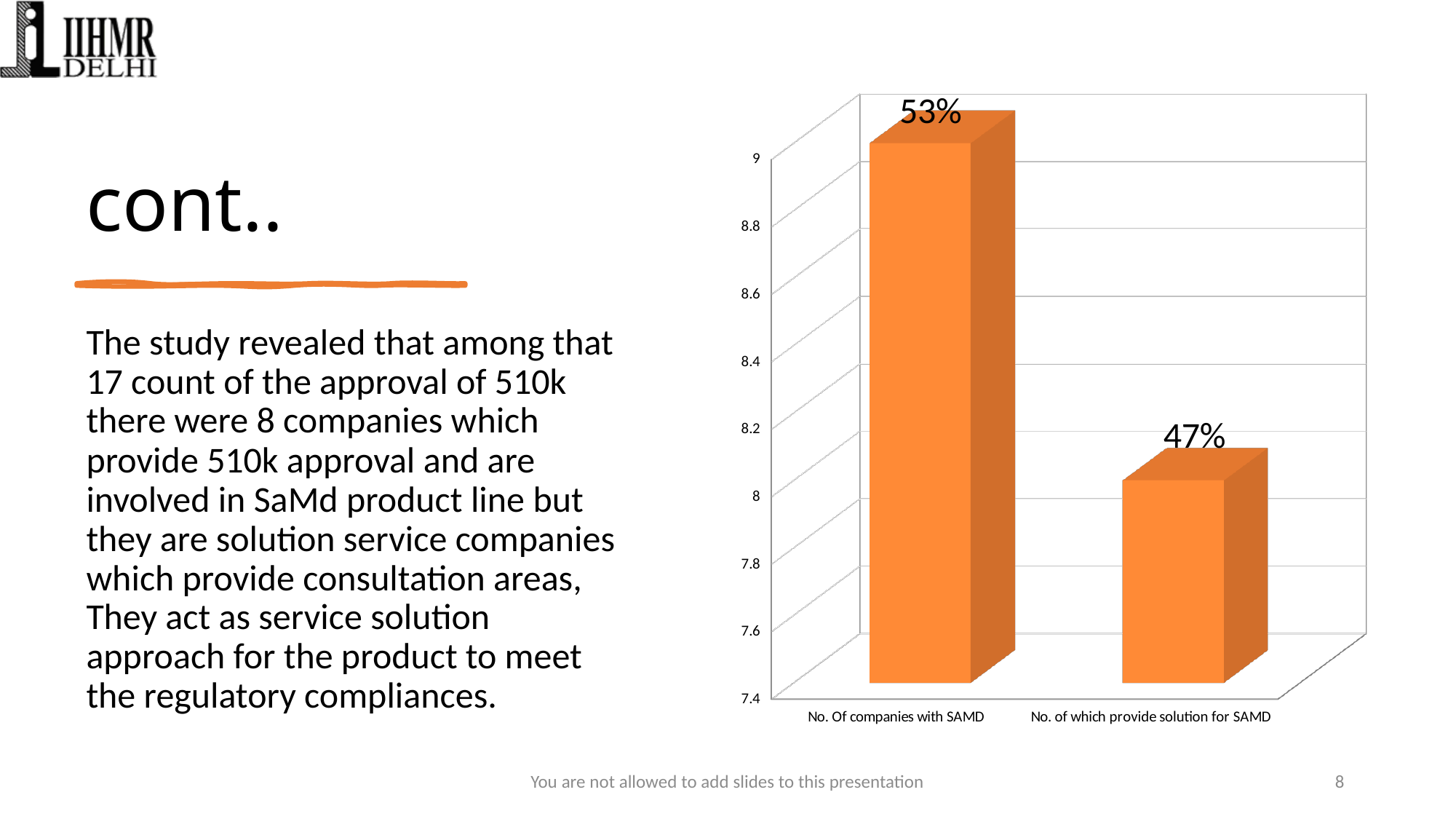
Is the bar for "No. Of companies with SAMD" taller or shorter than the bar for "No. of which provide solution for SAMD"? taller Which category has the shorter bar? No. of which provide solution for SAMD What is the lowest value shown on the vertical axis of the chart? 7.4 Do the bars rise or fall from left to right? fall What is the difference between the data labels 53% and 47% shown on the two bars? 6% Is the bar for "No. of which provide solution for SAMD" greater or less than 8.4 on the vertical axis? less What data label is shown on the bar for "No. Of companies with SAMD"? 53% Is the bar for "No. Of companies with SAMD" greater or less than 8.6 on the vertical axis? greater What data label is shown on the bar for "No. of which provide solution for SAMD"? 47% How many bars are plotted in the chart? 2 Which category has the taller bar? No. Of companies with SAMD What kind of chart is shown on the slide? bar chart